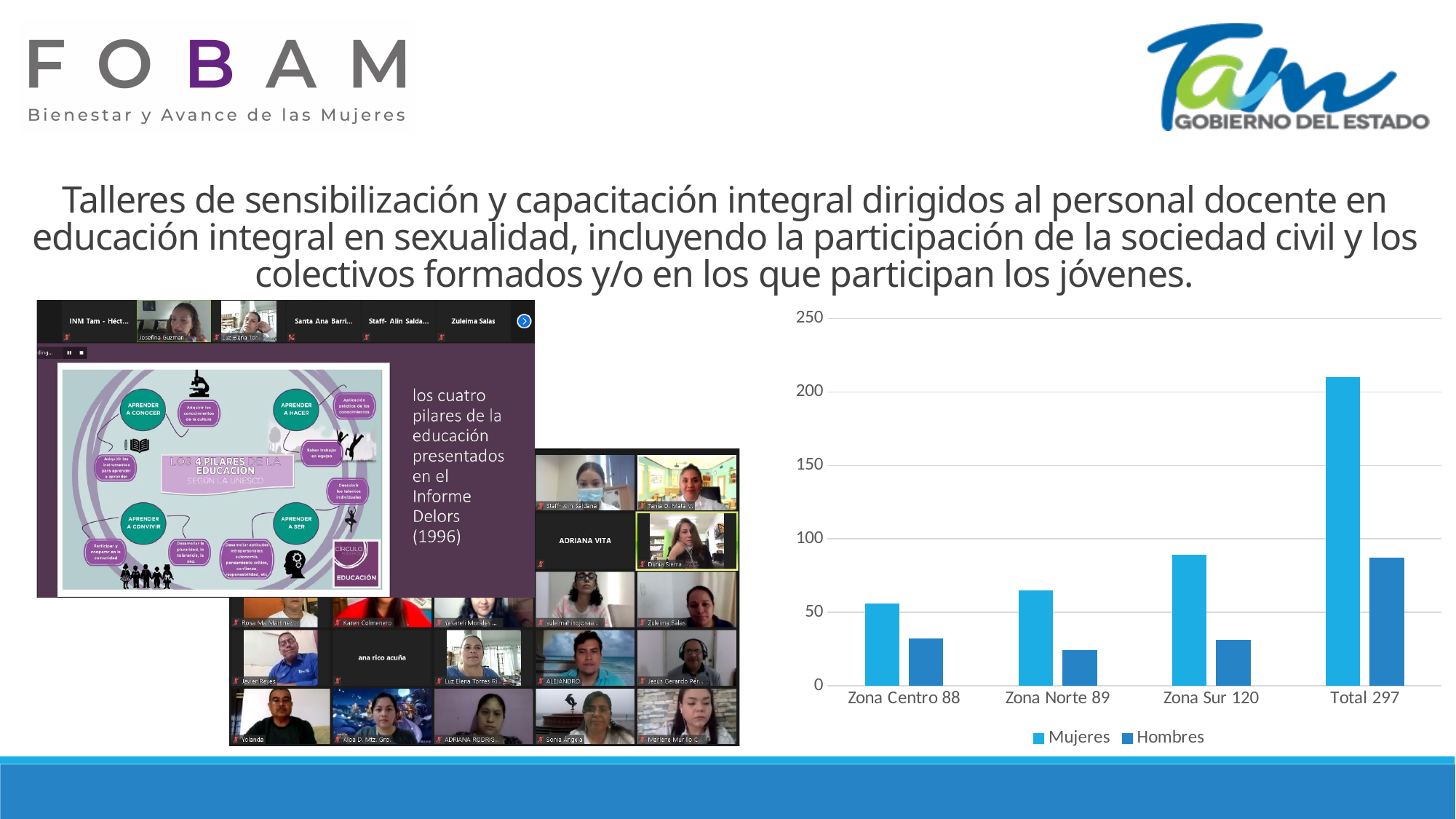
How many categories are shown along the x axis of the chart? 4 Is the Hombres value for Zona Centro 88 greater or less than 50? less Which is larger in Zona Norte 89, the Mujeres bar or the Hombres bar? Mujeres Which category has the shortest Hombres bar? Zona Norte 89 How many series does the chart legend list? 2 Do the Mujeres values rise or fall from Zona Centro 88 to Total 297 along the x axis? rise What is the highest value shown on the chart's vertical axis? 250 Is the Mujeres value for Zona Sur 120 greater or less than 100? less What are the two legend entries of the chart? Mujeres, Hombres Is the Mujeres value for Total 297 greater or less than 200? greater What kind of chart is shown on the slide? bar chart Which category has the tallest Mujeres bar? Total 297